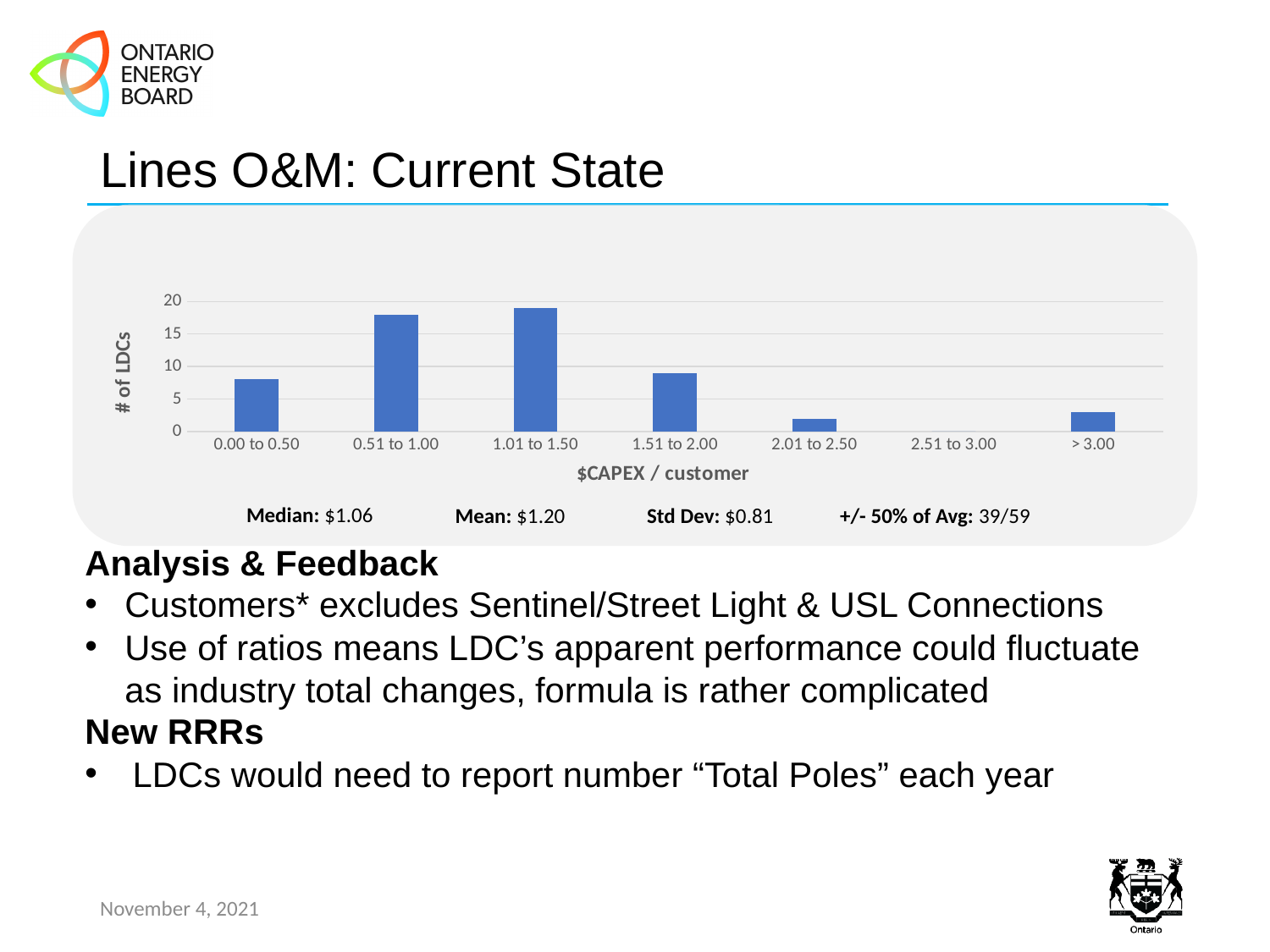
What kind of chart is shown on the slide? bar chart How many $CAPEX / customer categories are shown on the x axis? 7 Is the number of LDCs for 1.01 to 1.50 greater or less than 15? greater Is the number of LDCs for > 3.00 greater or less than 5? less What is the title of the y axis of the chart? # of LDCs Which has more LDCs, 1.51 to 2.00 or 2.01 to 2.50? 1.51 to 2.00 Is the number of LDCs for 0.00 to 0.50 greater or less than 10? less What median value is reported below the chart? $1.06 Which has more LDCs, 0.00 to 0.50 or 0.51 to 1.00? 0.51 to 1.00 Which $CAPEX / customer category has the lowest number of LDCs? 2.51 to 3.00